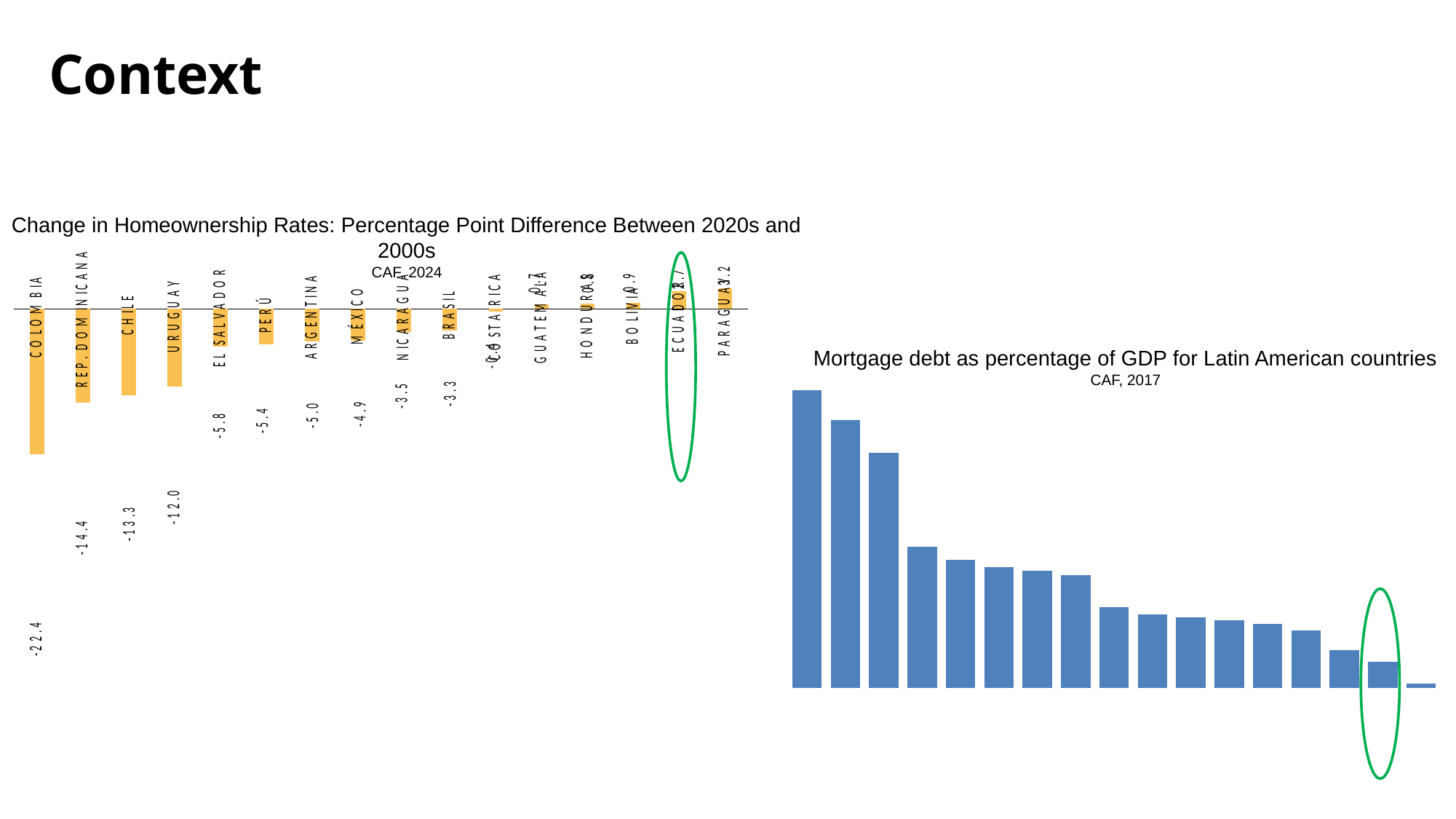
In the 'Change in Homeownership Rates' chart, which country has the lowest value? Colombia In the 'Change in Homeownership Rates' chart, what is the value for México? -4.9 How many countries are shown in the 'Change in Homeownership Rates' chart? 16 What source and year are given under the title of the 'Change in Homeownership Rates' chart? CAF, 2024 In the 'Change in Homeownership Rates' chart, which is larger, the value for Perú or the value for Argentina? Argentina What kind of chart is the 'Mortgage debt as percentage of GDP for Latin American countries' chart on the right? bar chart What kind of chart is the 'Change in Homeownership Rates' chart on the left? bar chart In the 'Mortgage debt as percentage of GDP for Latin American countries' chart, do the values rise or fall from left to right? fall In the 'Change in Homeownership Rates' chart, what is the value for Colombia? -22.4 In the 'Change in Homeownership Rates' chart, what is the difference between the values for Colombia and Rep. Dominicana? 8.0 In the 'Change in Homeownership Rates' chart, what is the value for Chile? -13.3 In the 'Change in Homeownership Rates' chart, what is the difference between the values for Rep. Dominicana and Uruguay? 2.4